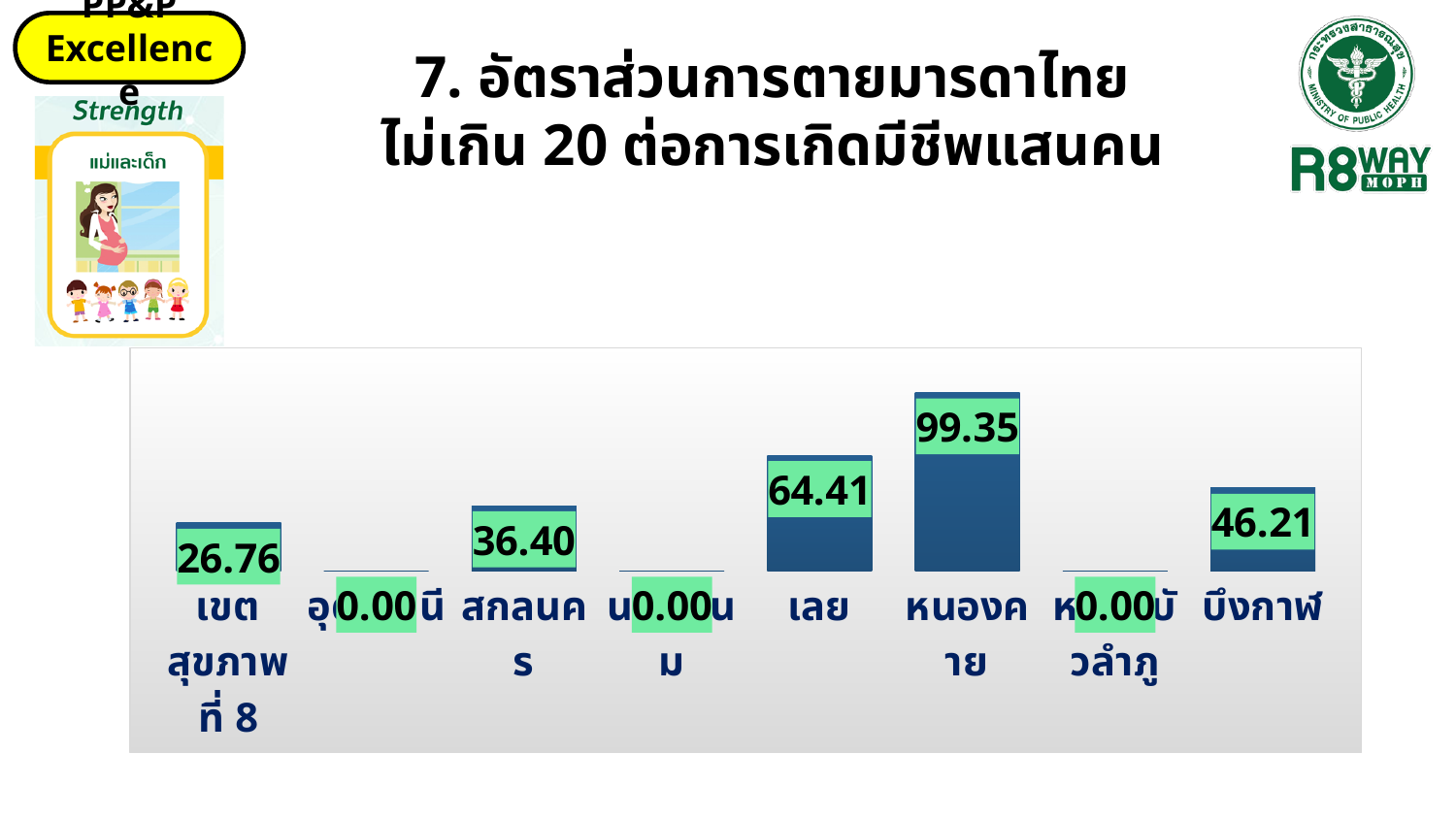
Which category has the highest value? หนองคาย What is the difference between the values for หนองคาย and เลย? 34.94 Which is larger, the value for สกลนคร or the value for บึงกาฬ? บึงกาฬ What is the value for หนองคาย? 99.35 What is the value for บึงกาฬ? 46.21 What is the value for เขตสุขภาพที่ 8? 26.76 What is the value for สกลนคร? 36.40 How many categories are shown in the chart? 8 How many categories have a value of 0.00? 3 What is the difference between the values for บึงกาฬ and เขตสุขภาพที่ 8? 19.45 What is the value for เลย? 64.41 What kind of chart is shown on the slide? bar chart